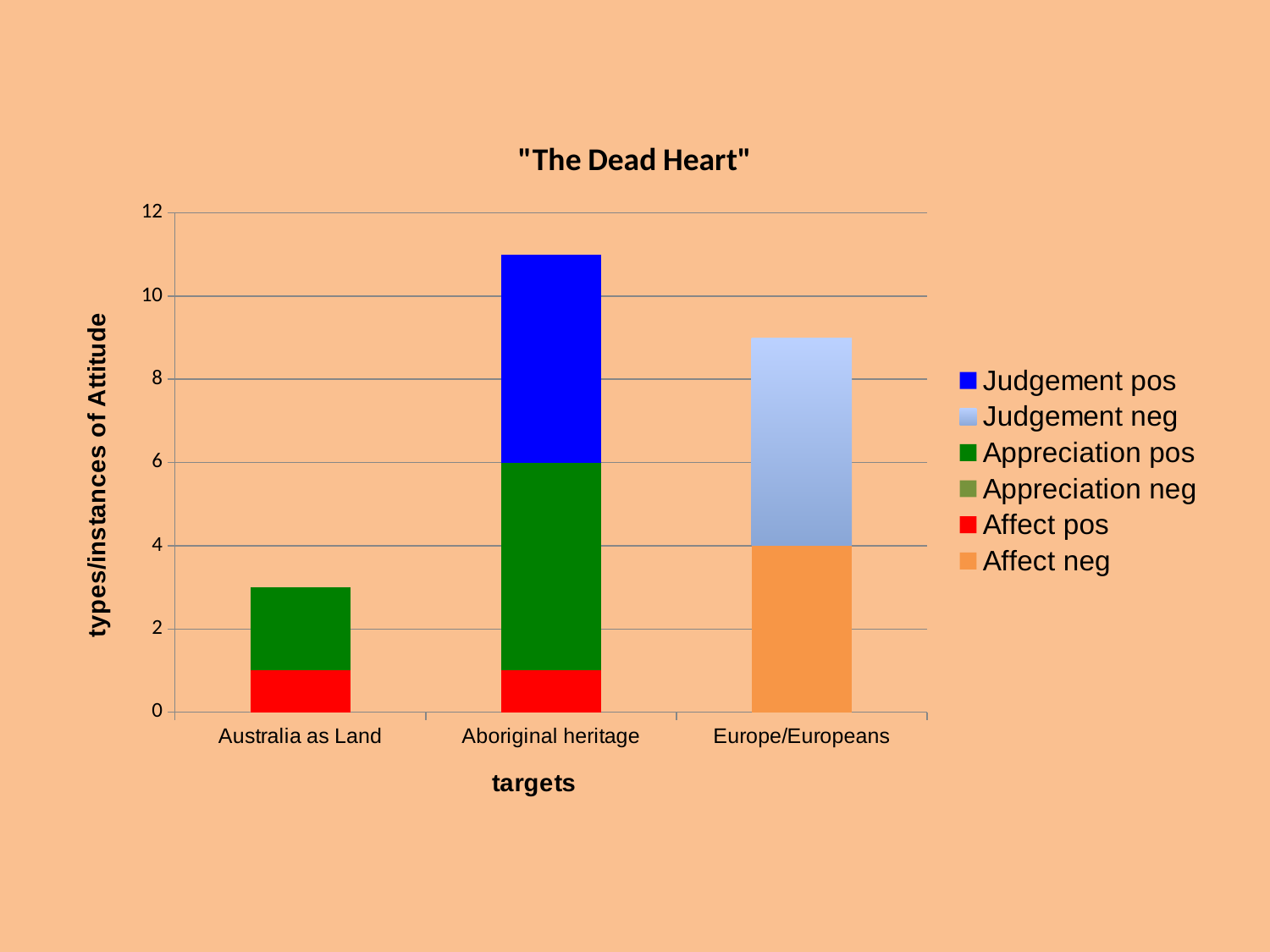
What is the title of the chart? "The Dead Heart" How many target categories are shown on the x axis? 3 What is the label of the y axis? types/instances of Attitude Is the total stacked bar for Aboriginal heritage greater or less than 10? greater Which target has the shortest stacked bar? Australia as Land Which target has the tallest stacked bar? Aboriginal heritage Is the total stacked bar for Australia as Land greater or less than 4? less How many series does the legend list? 6 What is the value of Affect neg for Europe/Europeans? 4 What kind of chart is shown on the slide? Stacked bar chart Which stacked bar is taller, Aboriginal heritage or Europe/Europeans? Aboriginal heritage Is the total stacked bar for Europe/Europeans greater or less than 8? greater